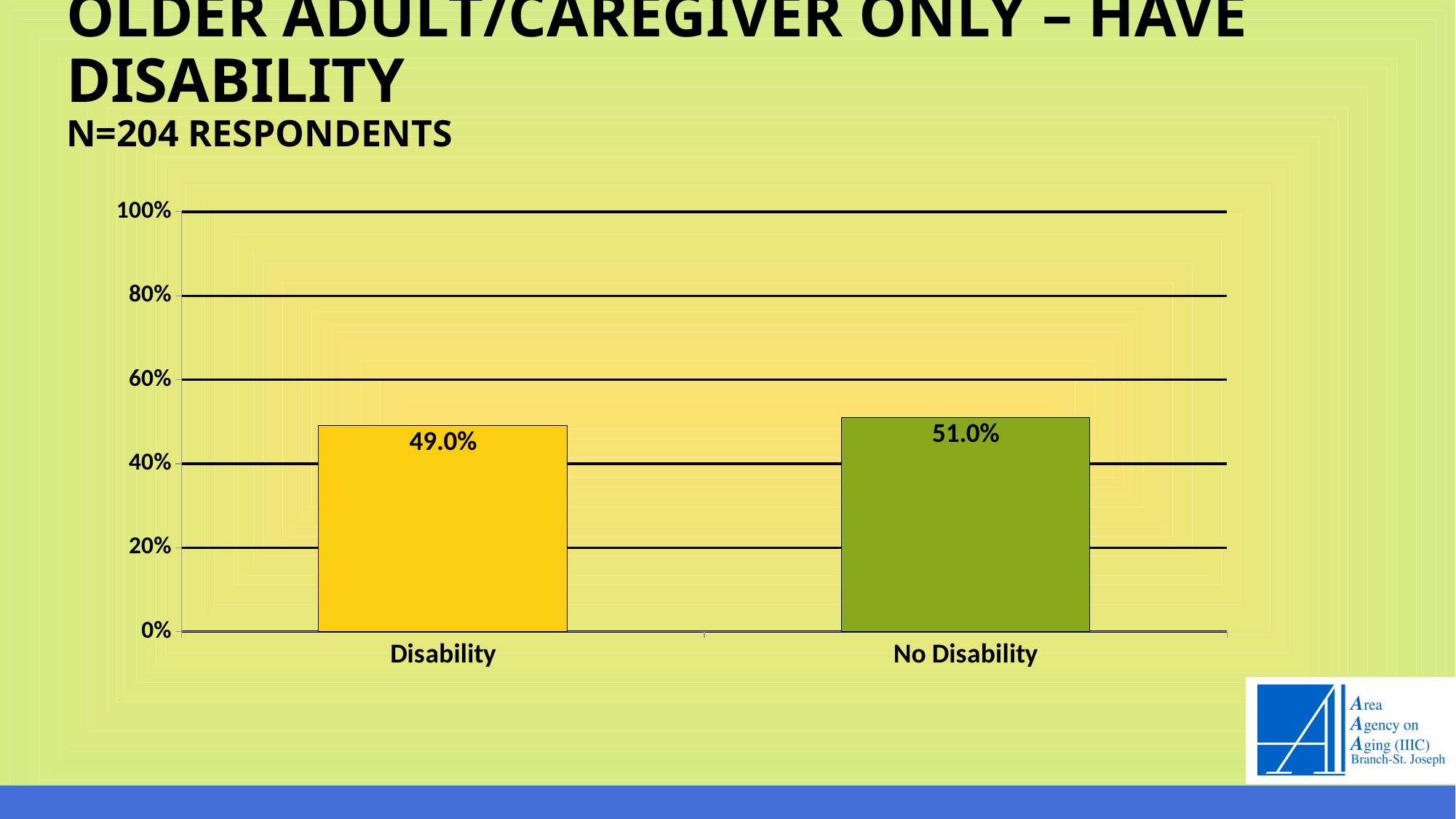
What is the value for Disability? 49.0% Is the value for No Disability greater or less than 40%? greater Which category has the highest value? No Disability Which category has the lowest value? Disability What colour is the bar for No Disability? green How many respondents does the slide say the chart is based on? 204 How many categories are shown on the chart? 2 What kind of chart is shown on the slide? bar chart What is the value for No Disability? 51.0% What is the difference between the values for No Disability and Disability? 2.0% Which is larger, the value for Disability or the value for No Disability? No Disability Is the value for Disability greater or less than 60%? less